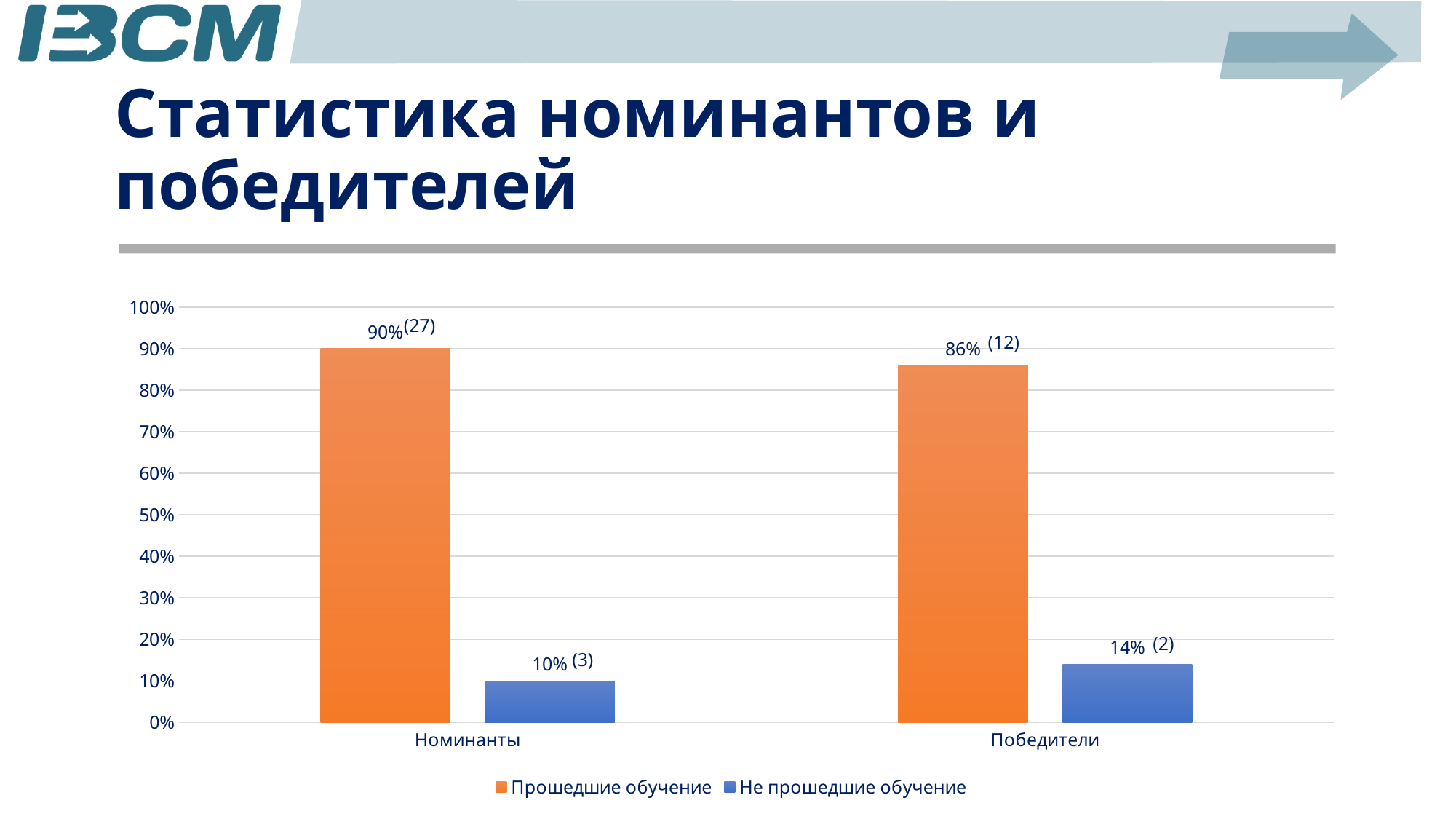
How many categories are shown on the x axis? 2 How many people are shown in parentheses for Прошедшие обучение among Номинанты? 27 How many series does the legend list? 2 What is the value for Не прошедшие обучение in the Номинанты category? 10% What is the difference between the Прошедшие обучение values for Номинанты and Победители? 4% Is the value for Не прошедшие обучение among Победители larger or smaller than among Номинанты? larger Which category has the higher value for Прошедшие обучение? Номинанты What is the value for Прошедшие обучение in the Номинанты category? 90% What is the value for Не прошедшие обучение in the Победители category? 14% What kind of chart is shown on the slide? bar chart Which category has the lower value for Не прошедшие обучение? Номинанты What is the value for Прошедшие обучение in the Победители category? 86%